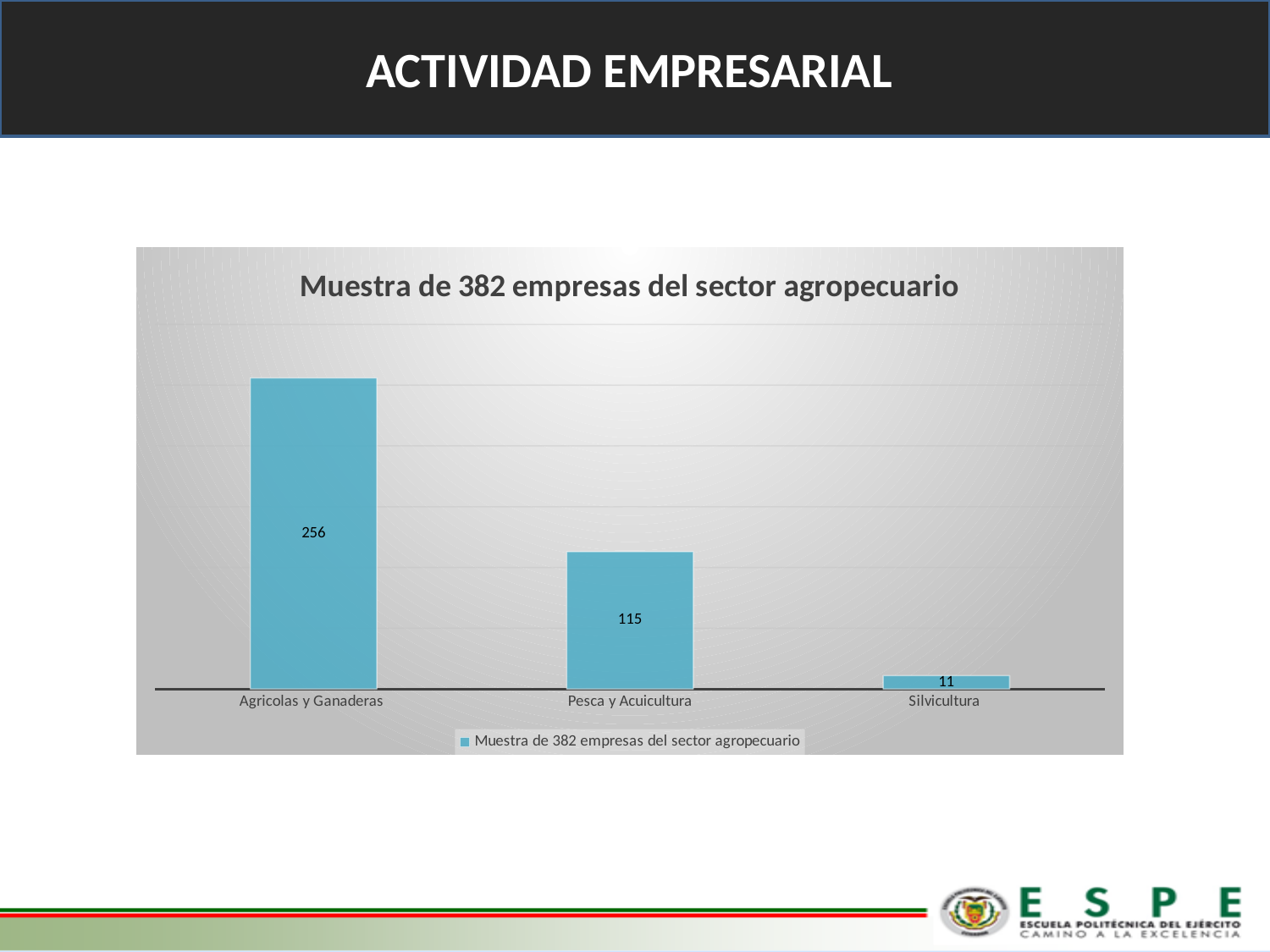
What kind of chart is shown on the slide? Bar chart How many series does the legend list? 1 What is the title of the chart? Muestra de 382 empresas del sector agropecuario Which is larger, the value for Pesca y Acuicultura or the value for Silvicultura? Pesca y Acuicultura Which category has the highest value? Agricolas y Ganaderas What is the difference between the values for Pesca y Acuicultura and Silvicultura? 104 How many categories are shown on the x axis? 3 Which category has the lowest value? Silvicultura What is the value for Pesca y Acuicultura? 115 What is the value for Agricolas y Ganaderas? 256 What is the difference between the values for Agricolas y Ganaderas and Pesca y Acuicultura? 141 What is the value for Silvicultura? 11